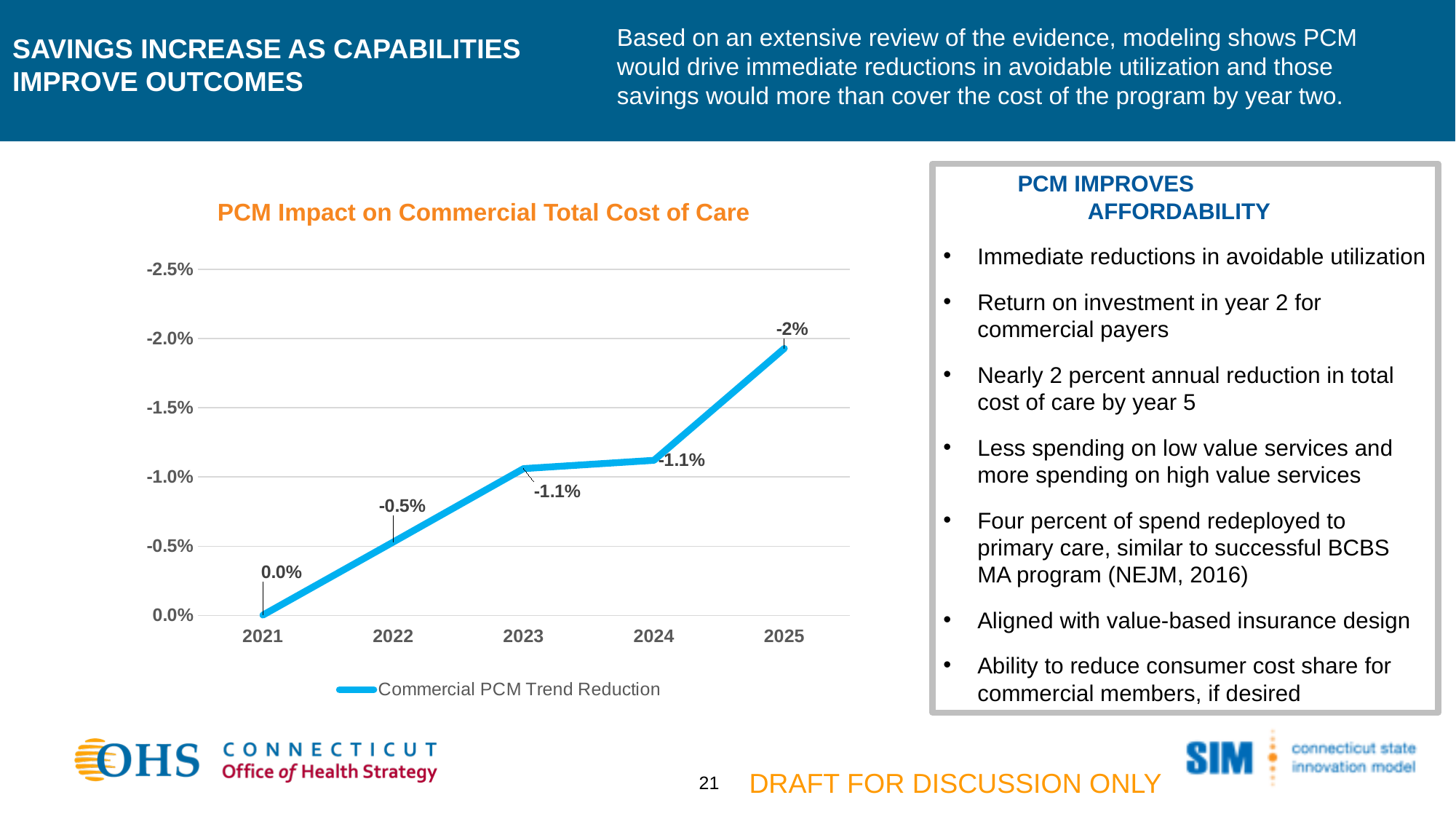
What is the Commercial PCM Trend Reduction value for 2024? -1.1% What is the Commercial PCM Trend Reduction value for 2021? 0.0% What type of chart is shown on the slide? Line chart How many years are plotted on the x axis? 5 How many series does the legend list? 1 Does the cost-of-care reduction grow or shrink from 2021 to 2025? Grows Which year shows the largest reduction in commercial total cost of care? 2025 What is the Commercial PCM Trend Reduction value for 2025? -2% Which year shows the smallest reduction (closest to zero)? 2021 What is the Commercial PCM Trend Reduction value for 2022? -0.5% What is the title of the chart? PCM Impact on Commercial Total Cost of Care By how many percentage points does the reduction in 2025 exceed the reduction in 2022? 1.5 percentage points